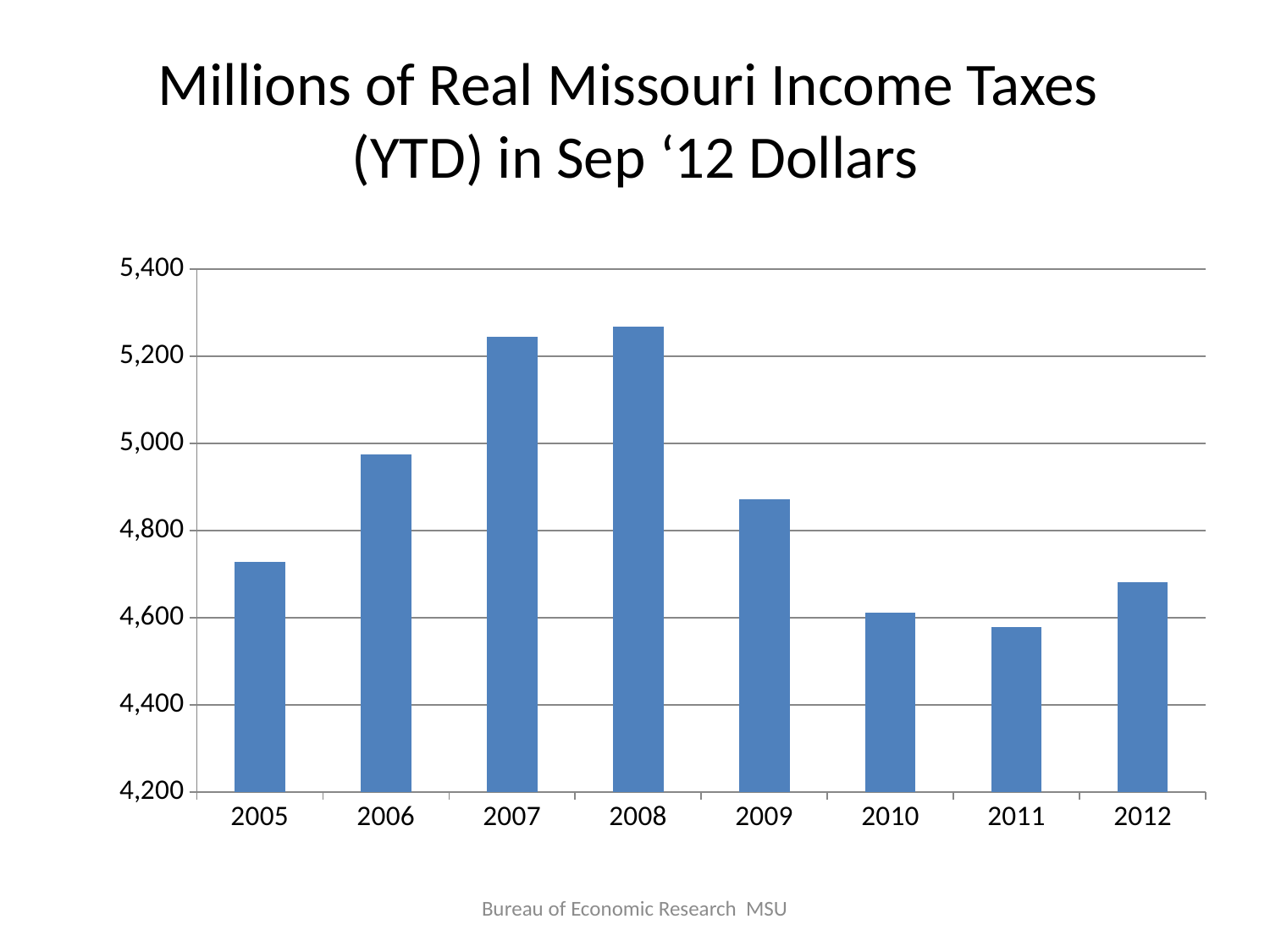
Is the value for 2007 greater or less than 5,200? greater Which year has the lowest value in the chart? 2011 Is the value for 2006 greater or less than 5,000? less Is the value for 2011 greater or less than 4,600? less Which is larger, the value for 2006 or the value for 2009? 2006 What is the title of the chart on the slide? Millions of Real Missouri Income Taxes (YTD) in Sep '12 Dollars How many years are shown on the x axis of the chart? 8 Which year has the highest value in the chart? 2008 Do the values rise or fall from 2008 to 2011? fall What source is credited at the bottom of the slide? Bureau of Economic Research MSU What kind of chart is shown on the slide? Bar chart